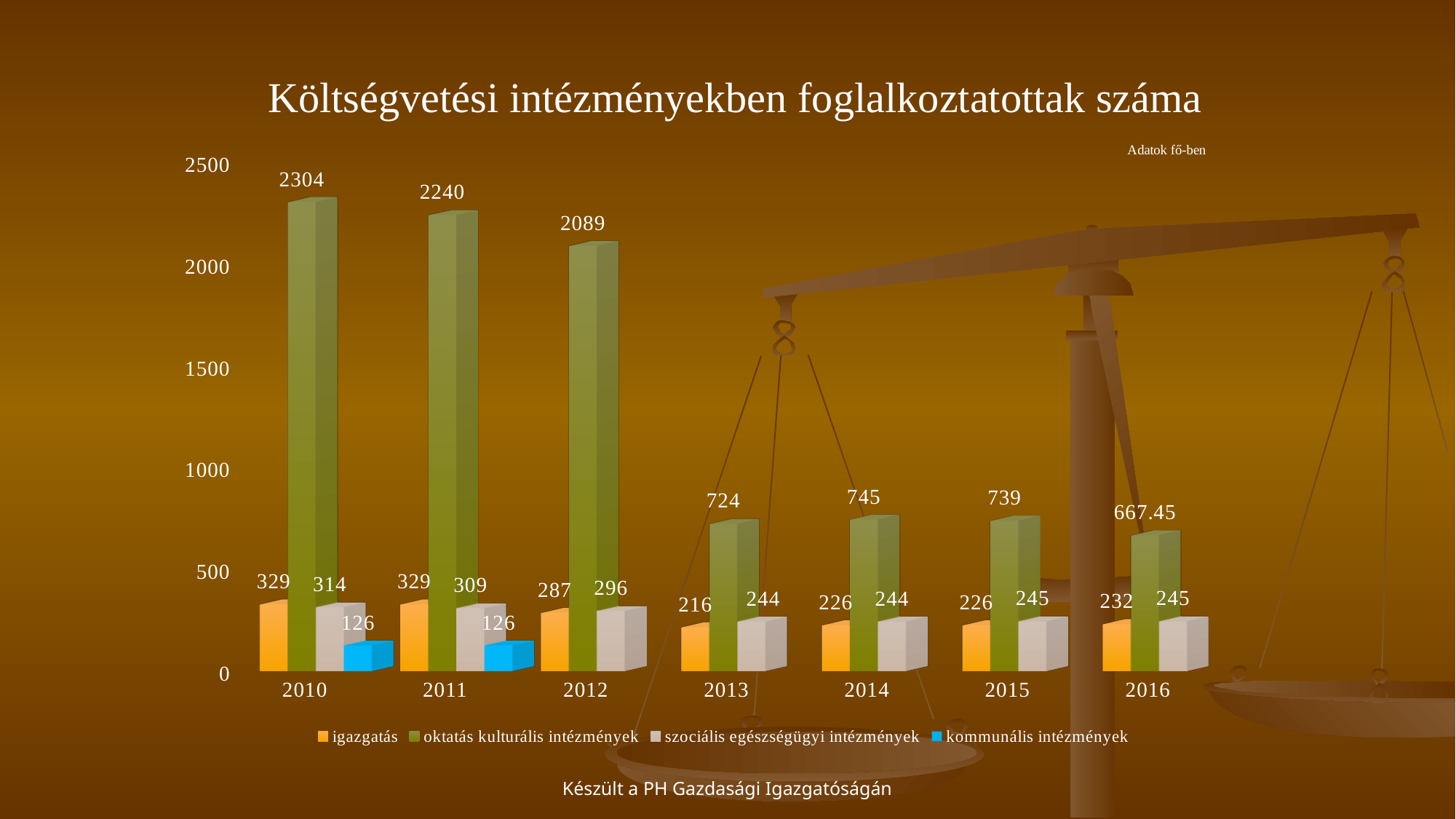
What kind of chart is shown on the slide? bar chart How many years are shown on the x axis? 7 What is the value for szociális egészségügyi intézmények in 2016? 245 In which year is the value for oktatás kulturális intézmények highest? 2010 In which year is the value for igazgatás lowest? 2013 What is the value for igazgatás in 2013? 216 What is the difference between the oktatás kulturális intézmények values for 2010 and 2011? 64 What is the title of the chart? Költségvetési intézményekben foglalkoztatottak száma How many series does the legend list? 4 Which is larger, the igazgatás value for 2012 or the szociális egészségügyi intézmények value for 2012? szociális egészségügyi intézmények (296) What is the value for oktatás kulturális intézmények in 2010? 2304 What is the value for oktatás kulturális intézmények in 2016? 667.45